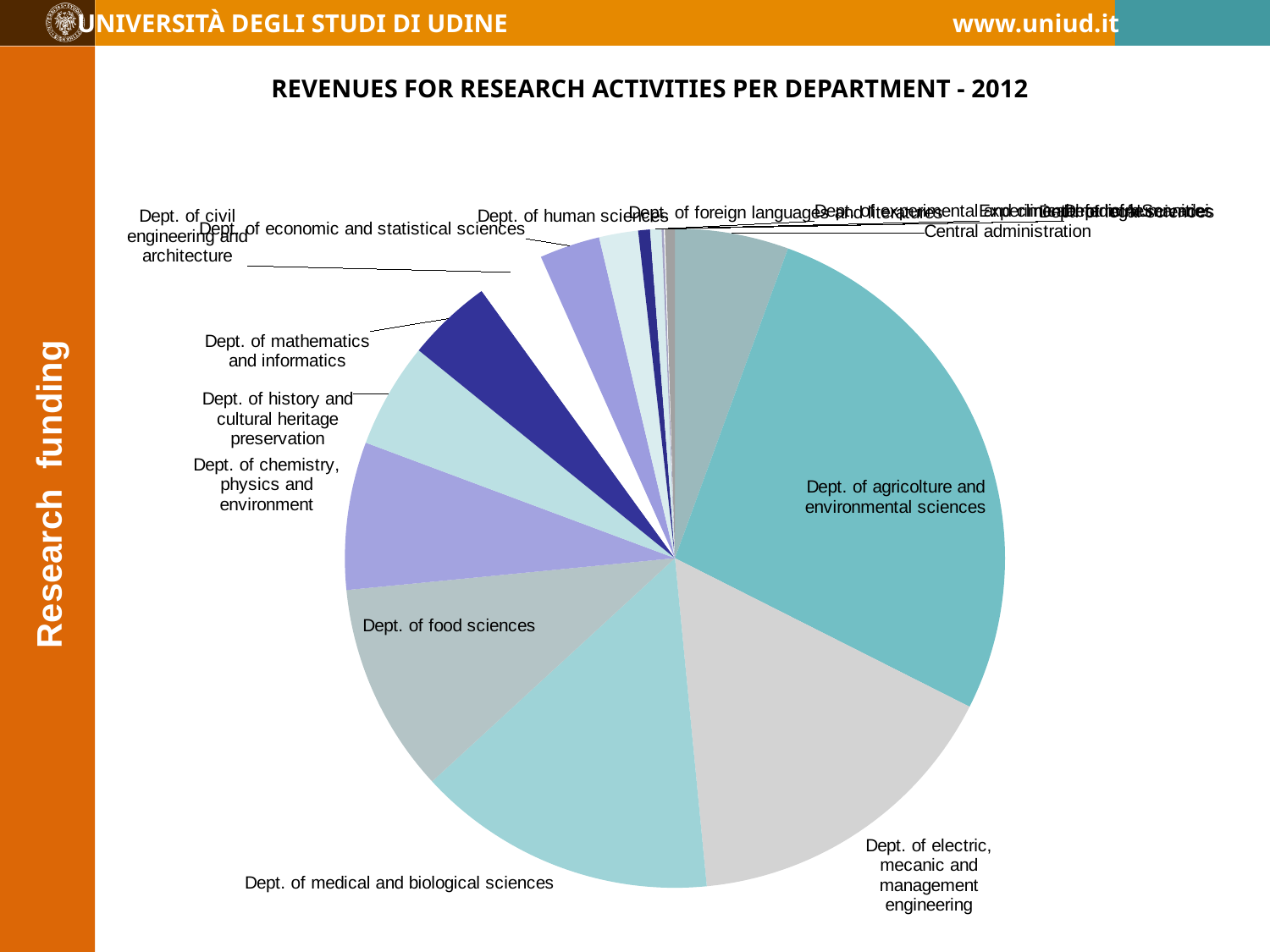
Which slice is larger: Dept. of food sciences or Dept. of history and cultural heritage preservation? Dept. of food sciences What kind of chart is shown on the slide? pie chart Which slice is larger: Dept. of medical and biological sciences or Dept. of mathematics and informatics? Dept. of medical and biological sciences Which slice is larger: Dept. of electric, mecanic and management engineering or Dept. of chemistry, physics and environment? Dept. of electric, mecanic and management engineering Which year does the chart refer to? 2012 What is the title of the chart? REVENUES FOR RESEARCH ACTIVITIES PER DEPARTMENT - 2012 Which department has the largest slice of the pie? Dept. of agricolture and environmental sciences